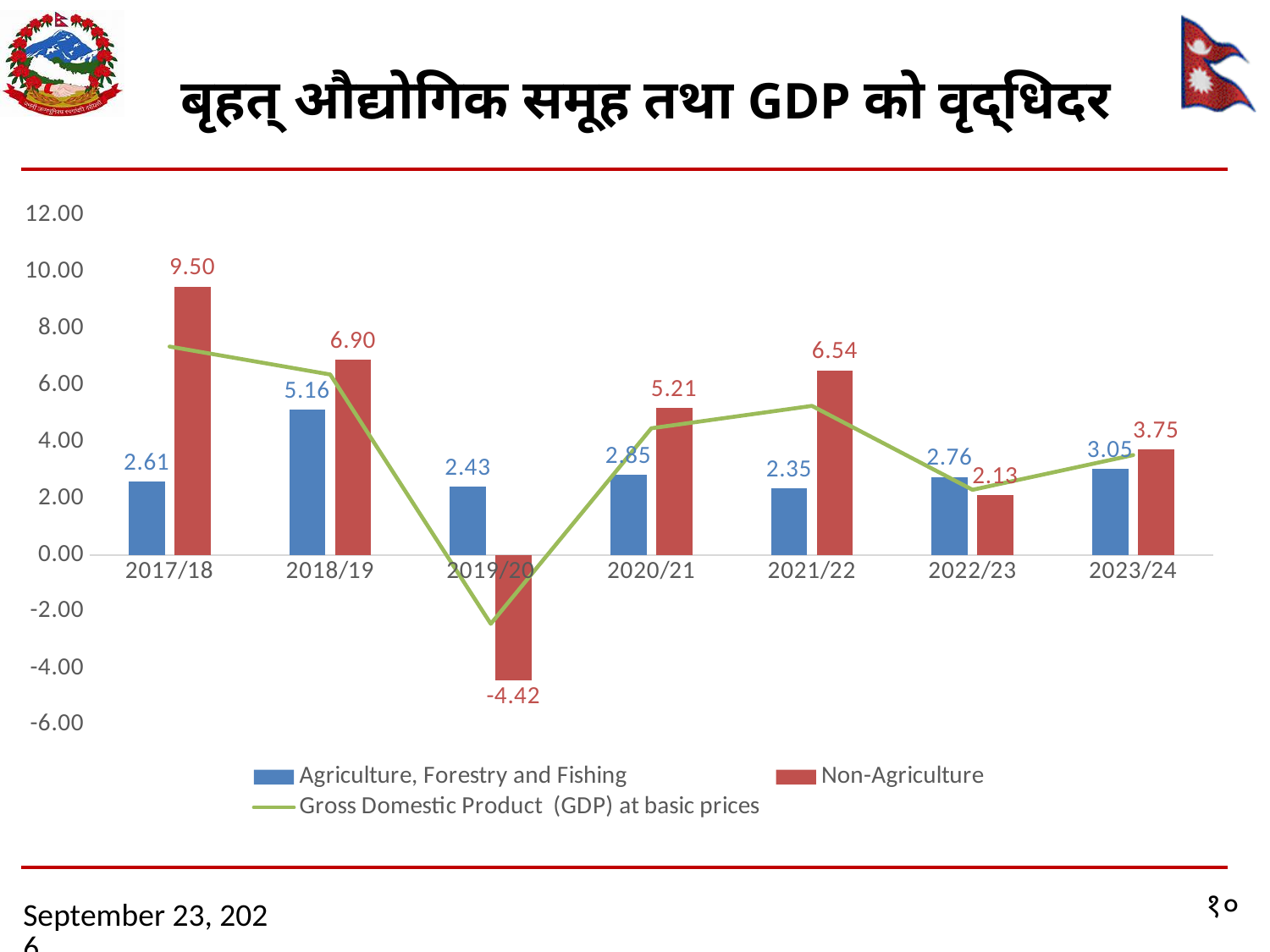
Is the Gross Domestic Product (GDP) at basic prices value for 2019/20 greater or less than 0.00? less In 2022/23, which is larger: Agriculture, Forestry and Fishing or Non-Agriculture? Agriculture, Forestry and Fishing What is the Agriculture, Forestry and Fishing value for 2018/19? 5.16 Does the Non-Agriculture value rise or fall from 2017/18 to 2019/20? fall What is the Non-Agriculture value for 2017/18? 9.50 What is the difference between the Non-Agriculture and Agriculture, Forestry and Fishing values in 2021/22? 4.19 What is the Non-Agriculture value for 2023/24? 3.75 How many series does the legend list? 3 In which year is the Non-Agriculture value lowest? 2019/20 What is the Non-Agriculture value for 2019/20? -4.42 How many years are shown on the x axis? 7 In which year is the Agriculture, Forestry and Fishing value highest? 2018/19